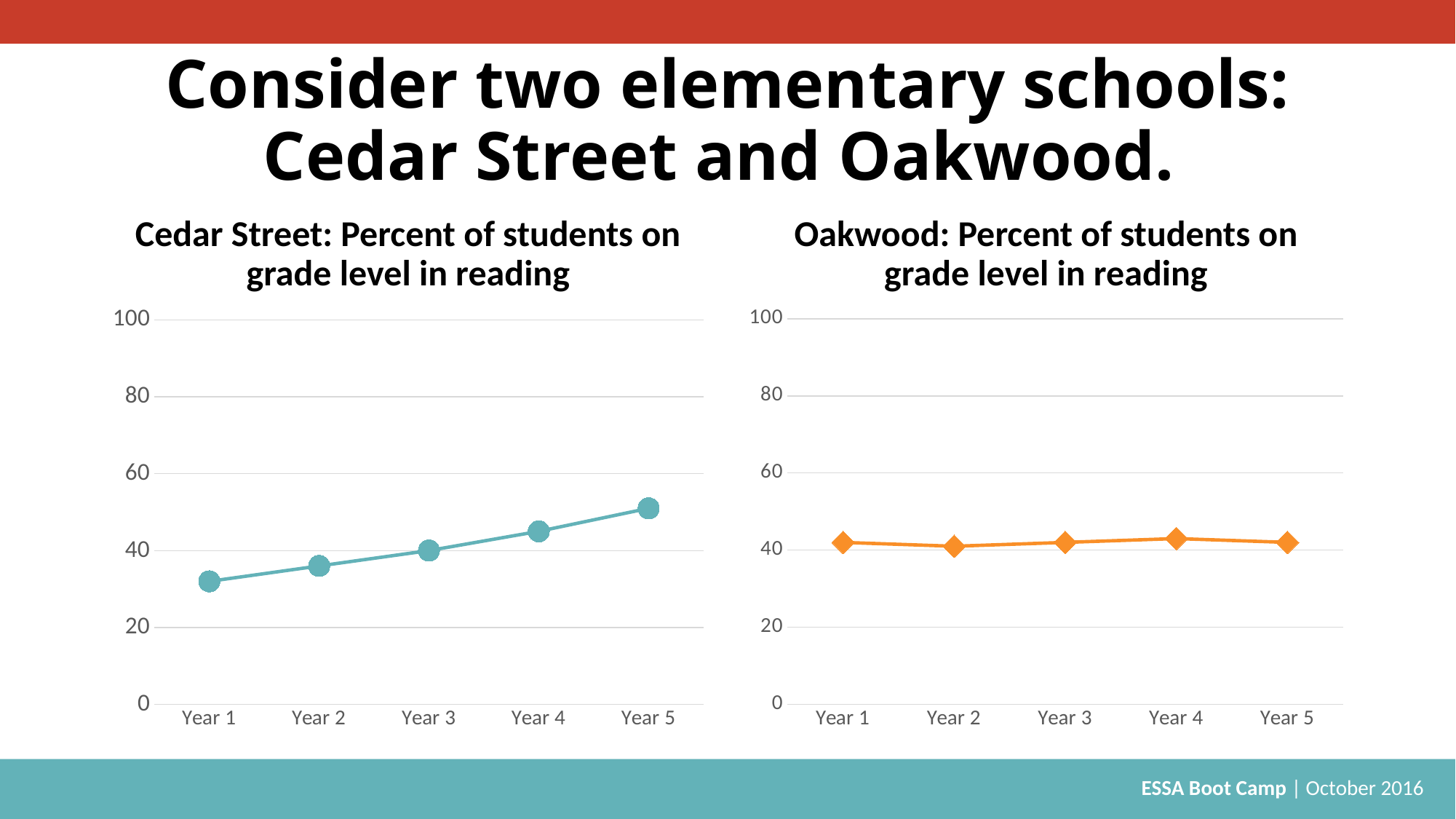
What kind of chart is the Oakwood chart on the right? line chart In the Cedar Street chart, is the value for Year 1 greater or less than 40? less In the Cedar Street chart, which is larger, the value for Year 2 or the value for Year 4? Year 4 In the Oakwood chart, how many data points are plotted? 5 In the Cedar Street chart, which year has the lowest percent of students on grade level in reading? Year 1 What kind of chart is the Cedar Street chart on the left? line chart In the Oakwood chart, is the value for Year 3 greater or less than 60? less What is the title of the chart on the right? Oakwood: Percent of students on grade level in reading In the Cedar Street chart, is the value for Year 5 greater or less than 40? greater In the Cedar Street chart, which year has the highest percent of students on grade level in reading? Year 5 In the Cedar Street chart, how many years are plotted along the x axis? 5 In the Cedar Street chart, do the values rise or fall from Year 1 to Year 5? rise